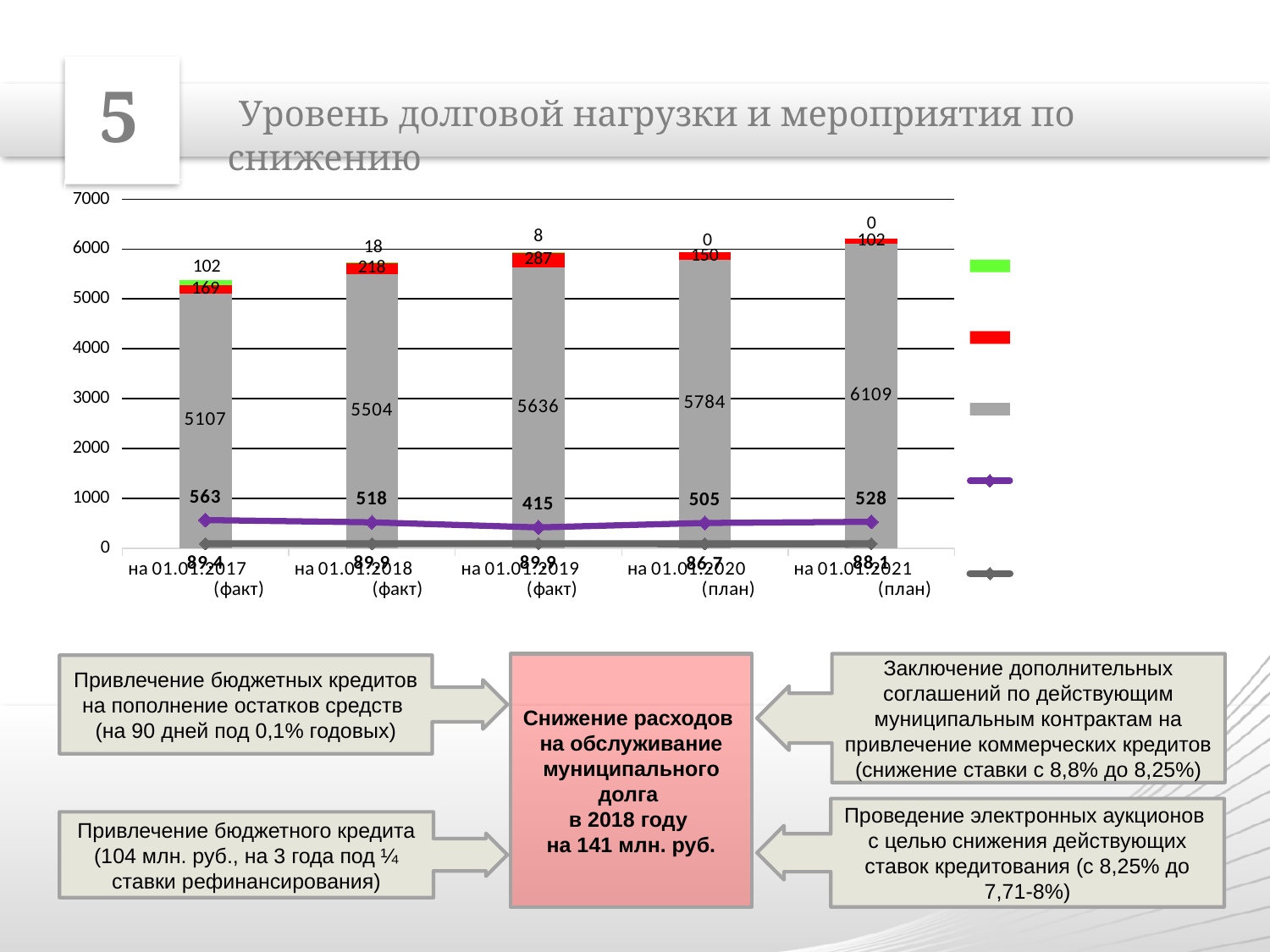
Which is larger, the red segment for на 01.01.2018 (факт) or for на 01.01.2020 (план)? на 01.01.2018 (факт) What is the value of the red bar segment for на 01.01.2019 (факт)? 287 How many categories are shown on the x axis? 5 What is the value of the purple line for на 01.01.2019 (факт)? 415 Which category has the lowest gray bar segment? на 01.01.2017 (факт) What is the difference between the gray bar segments for на 01.01.2021 (план) and на 01.01.2017 (факт)? 1002 What is the total of the stacked bar for на 01.01.2018 (факт) (gray, red and green segments)? 5740 At which category does the purple line reach its lowest value? на 01.01.2019 (факт) What is the value of the gray bar segment for на 01.01.2021 (план)? 6109 Which category has the highest gray bar segment? на 01.01.2021 (план) Do the gray bar segments rise or fall from на 01.01.2017 to на 01.01.2021? Rise What kind of chart is shown on the slide? Stacked bar chart combined with line series